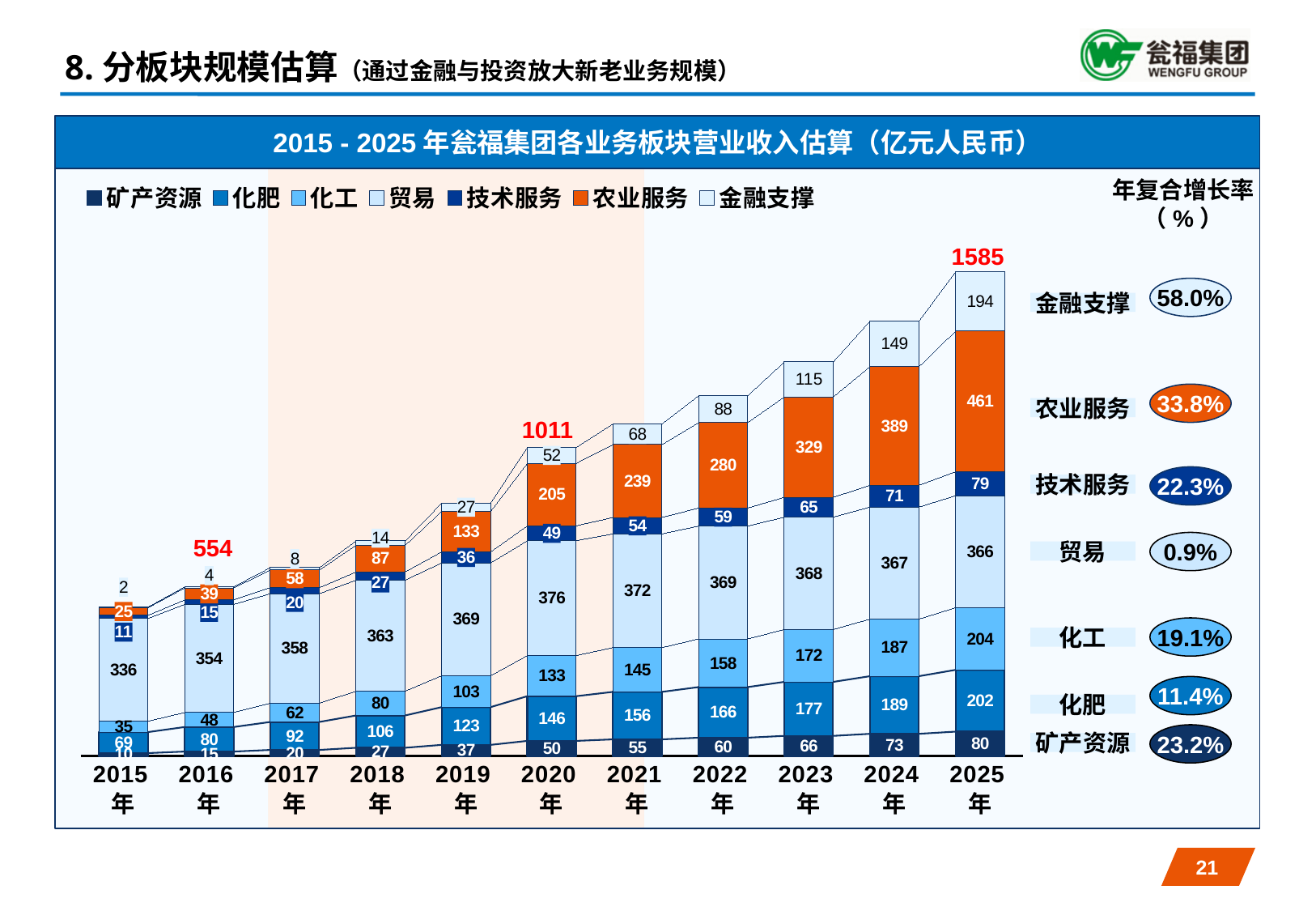
What is the value of 农业服务 in 2025? 461 What is the total labeled for the 2025 stacked bar? 1585 What is the difference between 农业服务 in 2025 and 农业服务 in 2024? 72 What kind of chart is this? Stacked bar chart How many years are shown on the x axis? 11 What is the total labeled for the 2020 stacked bar? 1011 What is the value of 贸易 in 2020? 376 Which year has the lowest value for 金融支撑? 2015年 Which is larger in 2023: 化工 or 化肥? 化肥 What is the value of 化肥 in 2018? 106 How many series does the legend list? 7 Which year has the highest total revenue? 2025年